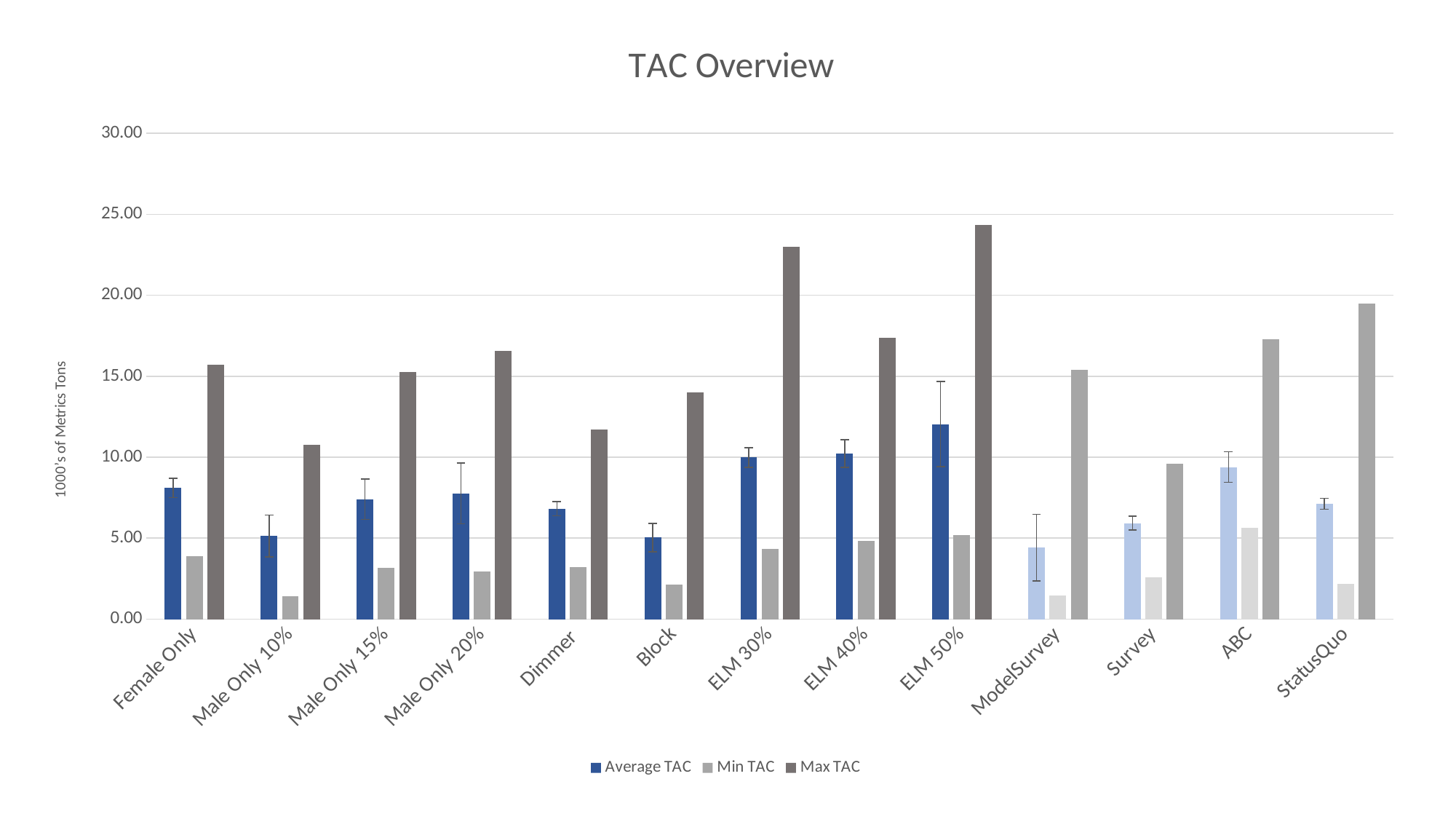
Which has the larger Max TAC value, Female Only or Male Only 10%? Female Only Which category has the highest Max TAC value? ELM 50% How many categories are shown on the x axis? 13 Which category has the highest Average TAC value? ELM 50% Is the Max TAC value for ELM 30% greater or less than 20.00? greater What type of chart is shown on the slide? Bar chart Is the Max TAC value for Block greater or less than 15.00? less How many series does the legend list? 3 Which category has the lowest Max TAC value? Survey Is the Average TAC value for Female Only greater or less than 5.00? greater What is the title of the chart? TAC Overview What is the label of the vertical axis? 1000's of Metrics Tons